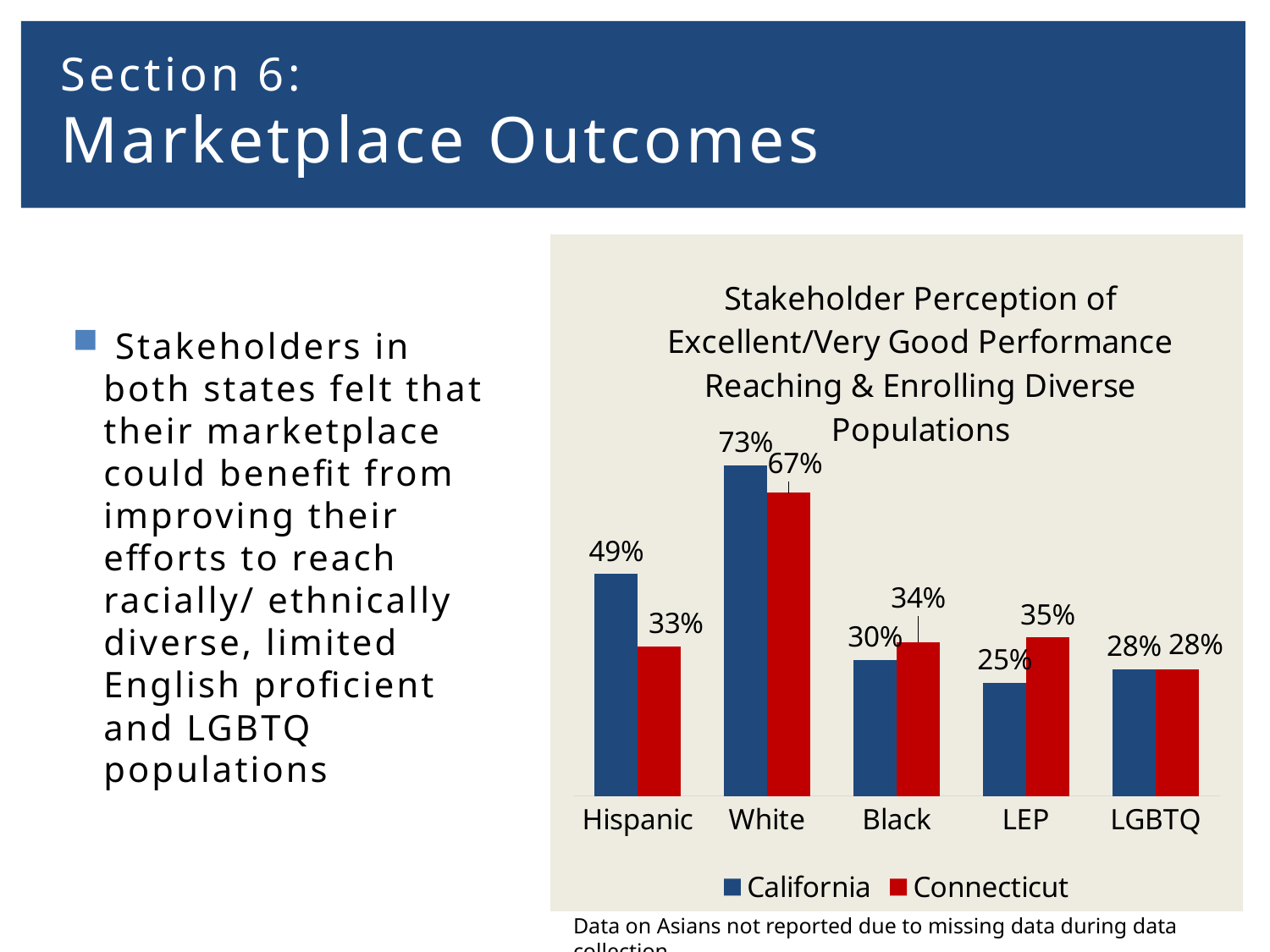
What is the difference between the California and Connecticut values for Hispanic? 16% What is the Connecticut value for White? 67% How many series does the legend list? 2 What is the California value for LEP? 25% What is the Connecticut value for Black? 34% Which is larger for LEP, the California value or the Connecticut value? Connecticut How many categories are shown on the x axis? 5 Which colour represents Connecticut in the chart? Red What is the California value for Hispanic? 49% Which category has the lowest Connecticut value? LGBTQ What kind of chart is shown on the slide? Bar chart Which category has the highest California value? White